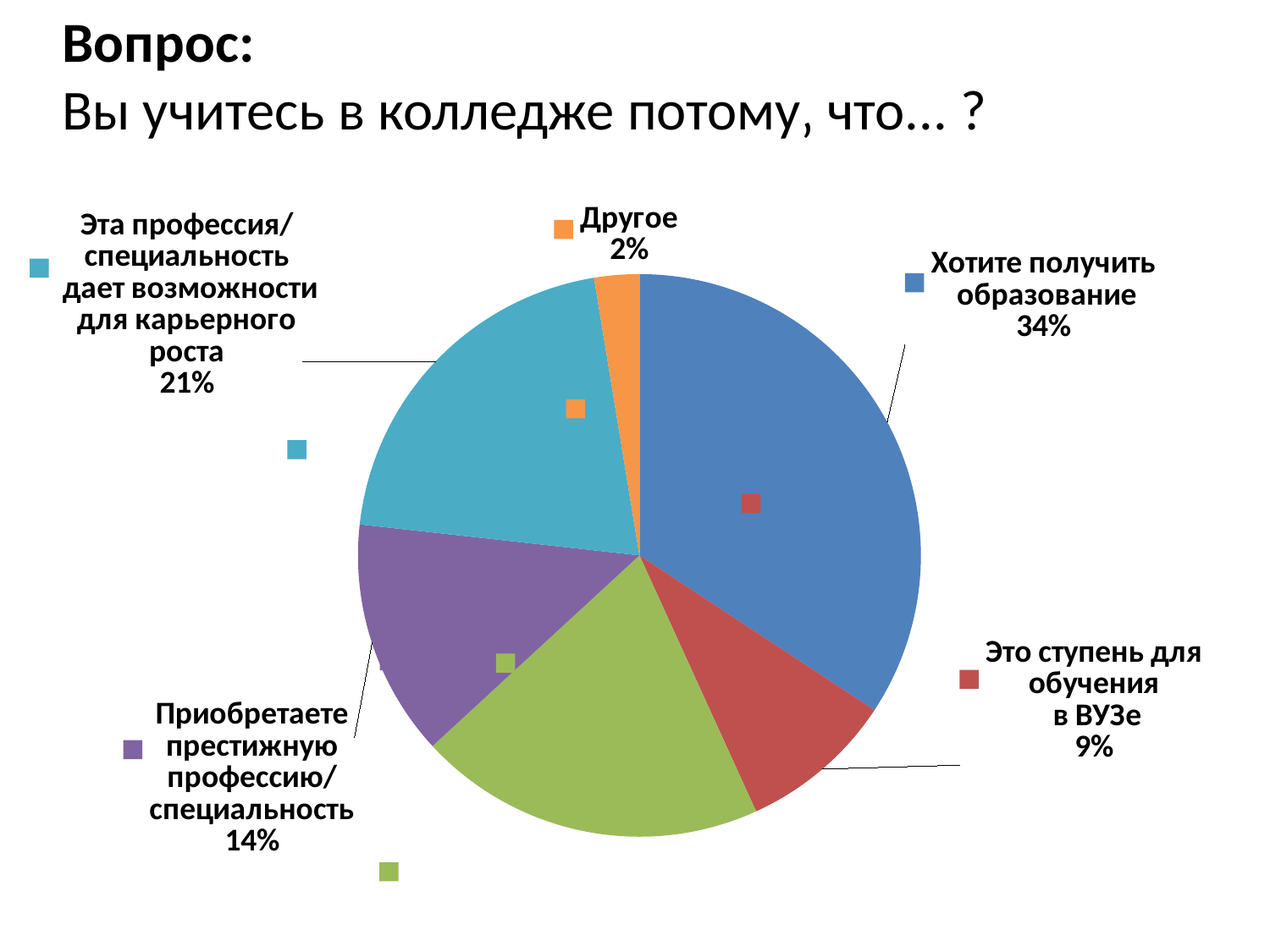
What share of respondents chose "Эта профессия/специальность дает возможности для карьерного роста"? 21% What share of respondents chose "Это ступень для обучения в ВУЗе"? 9% Which is larger: the share for "Приобретаете престижную профессию/специальность" or the share for "Это ступень для обучения в ВУЗе"? Приобретаете престижную профессию/специальность Which labelled answer has the smallest share of the pie? Другое How many slices does the pie chart have? 6 What colour is the slice for "Другое"? orange What share of respondents chose "Другое"? 2% What share of respondents chose "Приобретаете престижную профессию/специальность"? 14% What is the difference in percentage points between "Хотите получить образование" and "Эта профессия/специальность дает возможности для карьерного роста"? 13 What share of respondents chose "Хотите получить образование"? 34% What kind of chart is shown on the slide? pie chart Which labelled answer has the largest share of the pie? Хотите получить образование